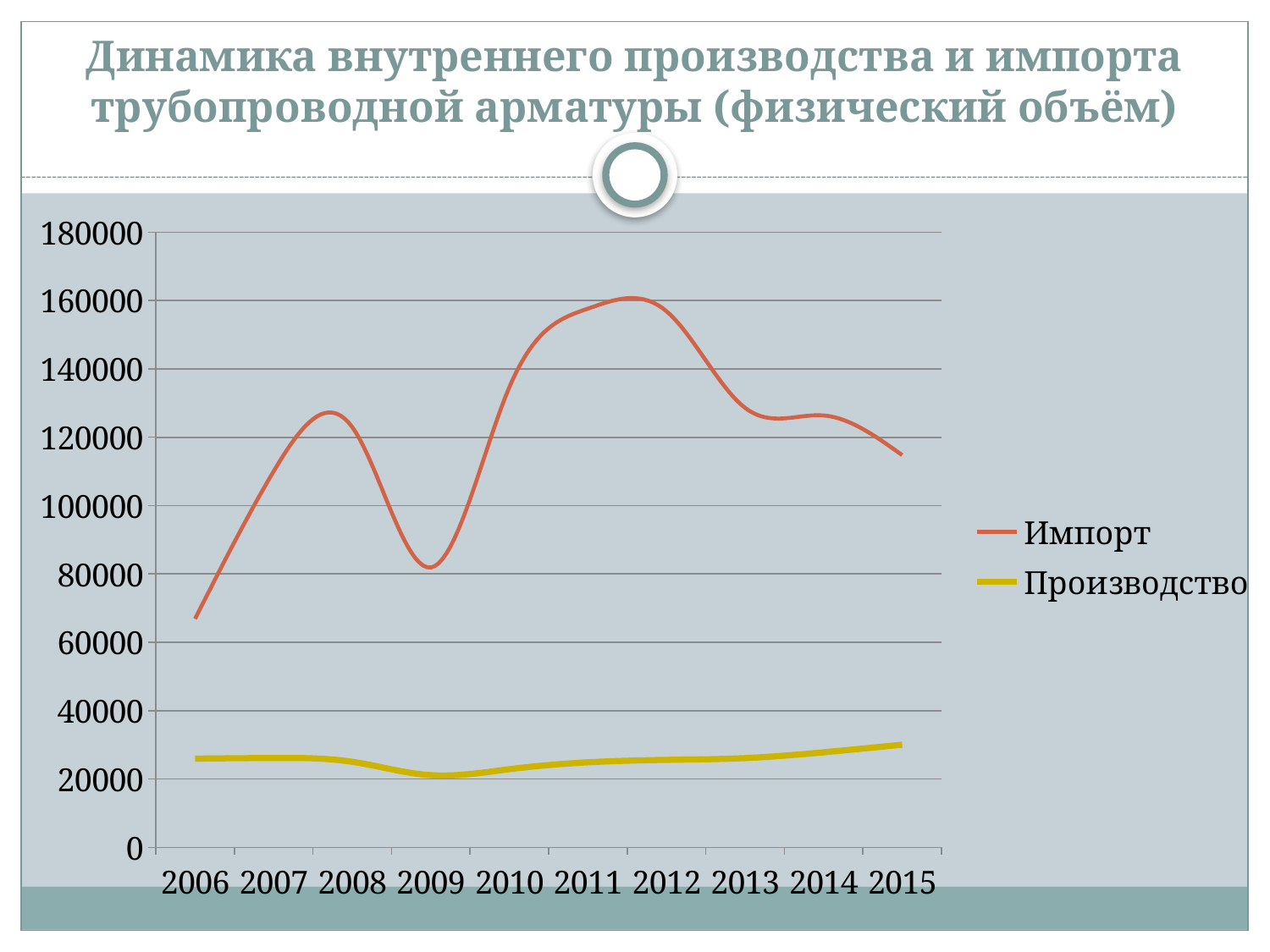
Does the value for Импорт rise or fall from 2012 to 2015? fall In which year is the value for Производство lowest? 2009 How many years are shown on the x axis? 10 What kind of chart is shown on the slide? line chart Is the value for Импорт in 2012 greater or less than 140000? greater Which is larger, the value for Импорт in 2008 or in 2009? 2008 Is the value for Производство in 2015 greater or less than 20000? greater Is the value for Импорт in 2006 greater or less than 80000? less In which year is the value for Импорт lowest? 2006 In which year is the value for Производство highest? 2015 Which series is drawn in yellow? Производство How many series does the legend list? 2